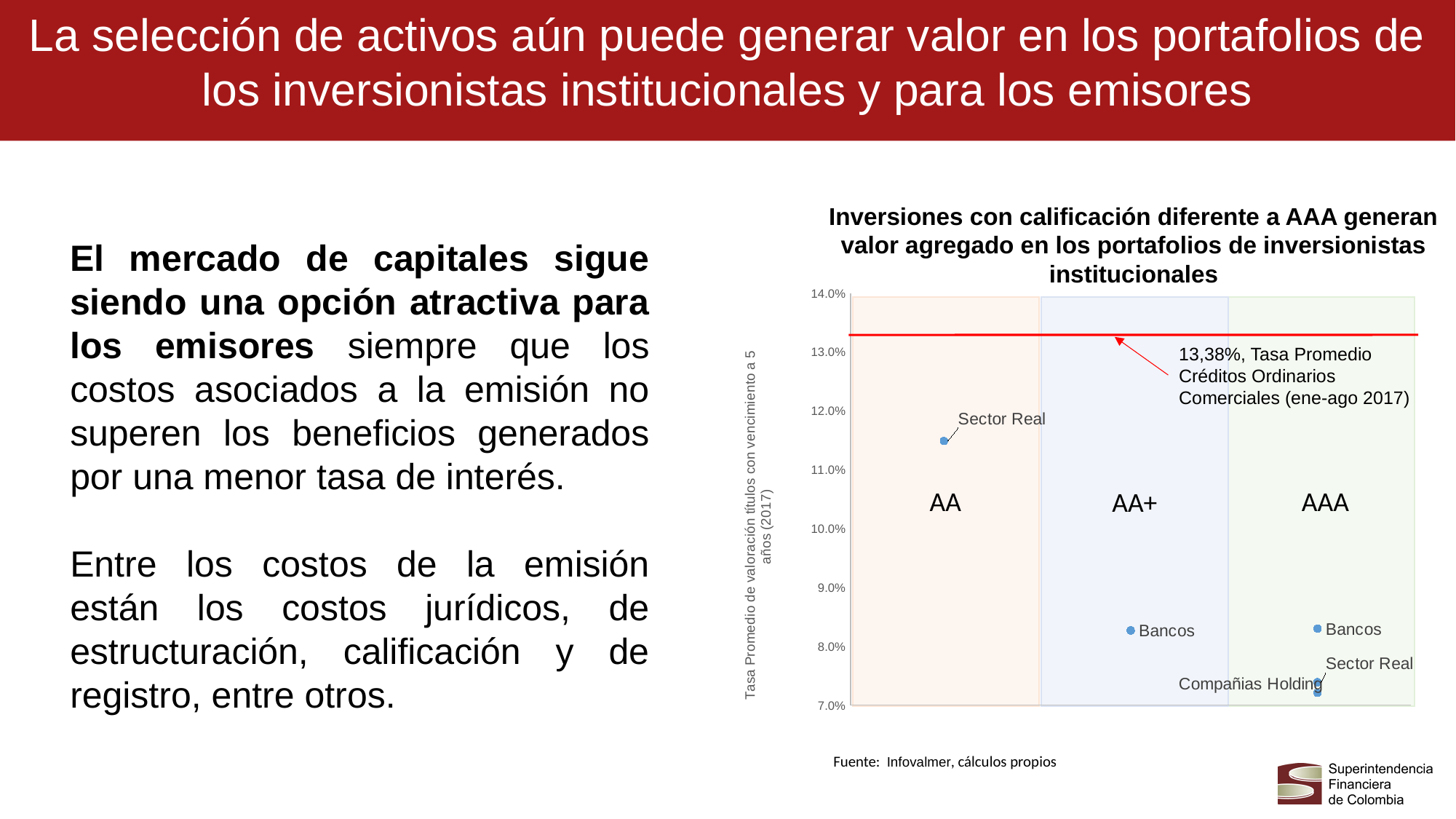
Is the value for Compañias Holding in the AAA group greater or less than 8.0%? less What value does the red horizontal line in the chart represent? 13,38% Is the value for Sector Real in the AA group greater or less than 11.0%? greater Which plotted point has the highest value in the chart? Sector Real (AA) What are the three rating groups shown along the x axis of the chart? AA, AA+, AAA What kind of chart is shown on the slide? scatter chart Is the value for Bancos in the AA+ group greater or less than 9.0%? less Which is larger: the value for Sector Real in the AA group or the value for Bancos in the AA+ group? Sector Real in the AA group Which is larger: the value for Bancos in the AAA group or the value for Sector Real in the AAA group? Bancos in the AAA group How many data points are plotted in the chart? 5 What is the title of the chart? Inversiones con calificación diferente a AAA generan valor agregado en los portafolios de inversionistas institucionales